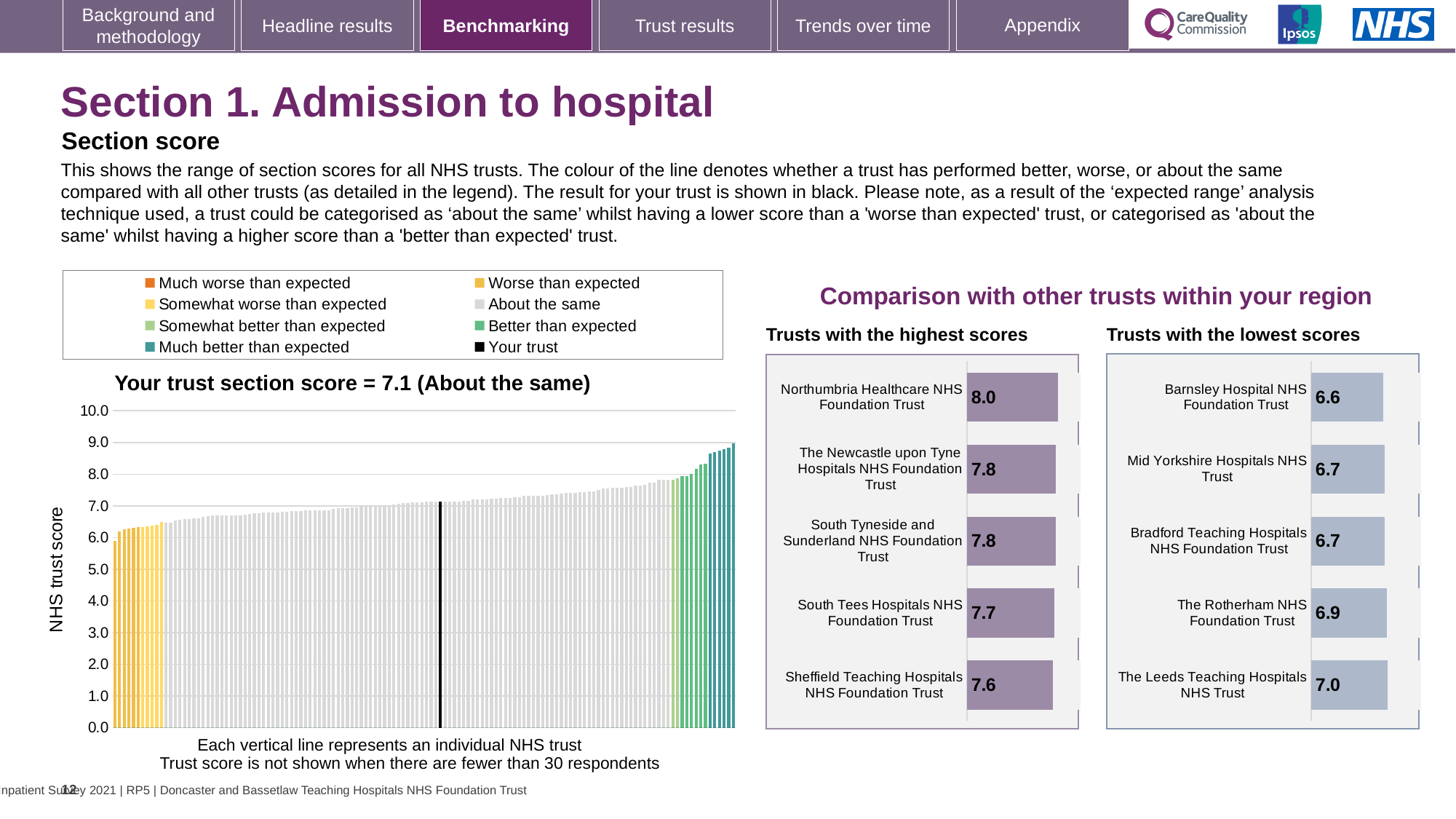
In the 'Trusts with the highest scores' chart, what is the difference between the scores of Northumbria Healthcare NHS Foundation Trust and Sheffield Teaching Hospitals NHS Foundation Trust? 0.4 In the 'Trusts with the lowest scores' chart, which trust has the lowest score? Barnsley Hospital NHS Foundation Trust How many entries does the legend above the left-hand chart list? 8 In the 'Trusts with the lowest scores' chart, what is the score for The Leeds Teaching Hospitals NHS Trust? 7.0 In the 'Trusts with the highest scores' chart, what is the score for Sheffield Teaching Hospitals NHS Foundation Trust? 7.6 In the 'Trusts with the lowest scores' chart, which has the larger score: The Rotherham NHS Foundation Trust or Mid Yorkshire Hospitals NHS Trust? The Rotherham NHS Foundation Trust In the 'Trusts with the highest scores' chart, what is the score for Northumbria Healthcare NHS Foundation Trust? 8.0 In the 'Trusts with the highest scores' chart, which trust has the highest score? Northumbria Healthcare NHS Foundation Trust In the 'Trusts with the lowest scores' chart, what is the score for Barnsley Hospital NHS Foundation Trust? 6.6 According to the title of the chart on the left, what is your trust's section score? 7.1 What kind of chart is the 'Your trust section score' chart on the left? Bar chart How many trusts are listed in the 'Trusts with the lowest scores' chart? 5